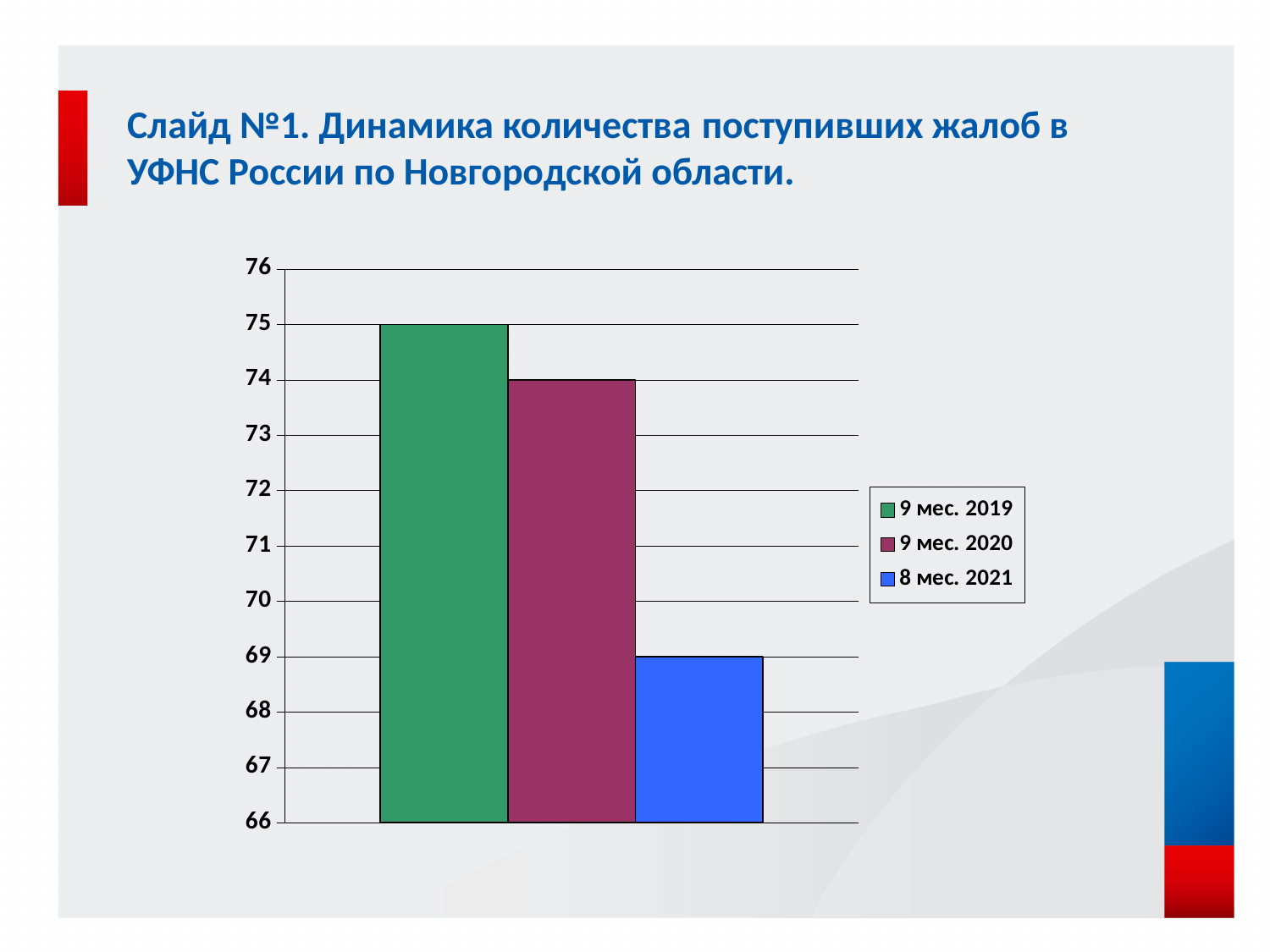
Which series has the highest value? 9 мес. 2019 How many series does the legend list? 3 What kind of chart is shown on the slide? bar chart What is the value for 9 мес. 2019? 75 What is the value for 9 мес. 2020? 74 Do the values rise or fall from 9 мес. 2019 to 8 мес. 2021? fall Is the value for 8 мес. 2021 greater or less than 70? less Which series has the lowest value? 8 мес. 2021 Which is larger, the value for 9 мес. 2020 or the value for 8 мес. 2021? 9 мес. 2020 What is the difference between the values for 9 мес. 2020 and 8 мес. 2021? 5 What is the difference between the values for 9 мес. 2019 and 8 мес. 2021? 6 What is the value for 8 мес. 2021? 69